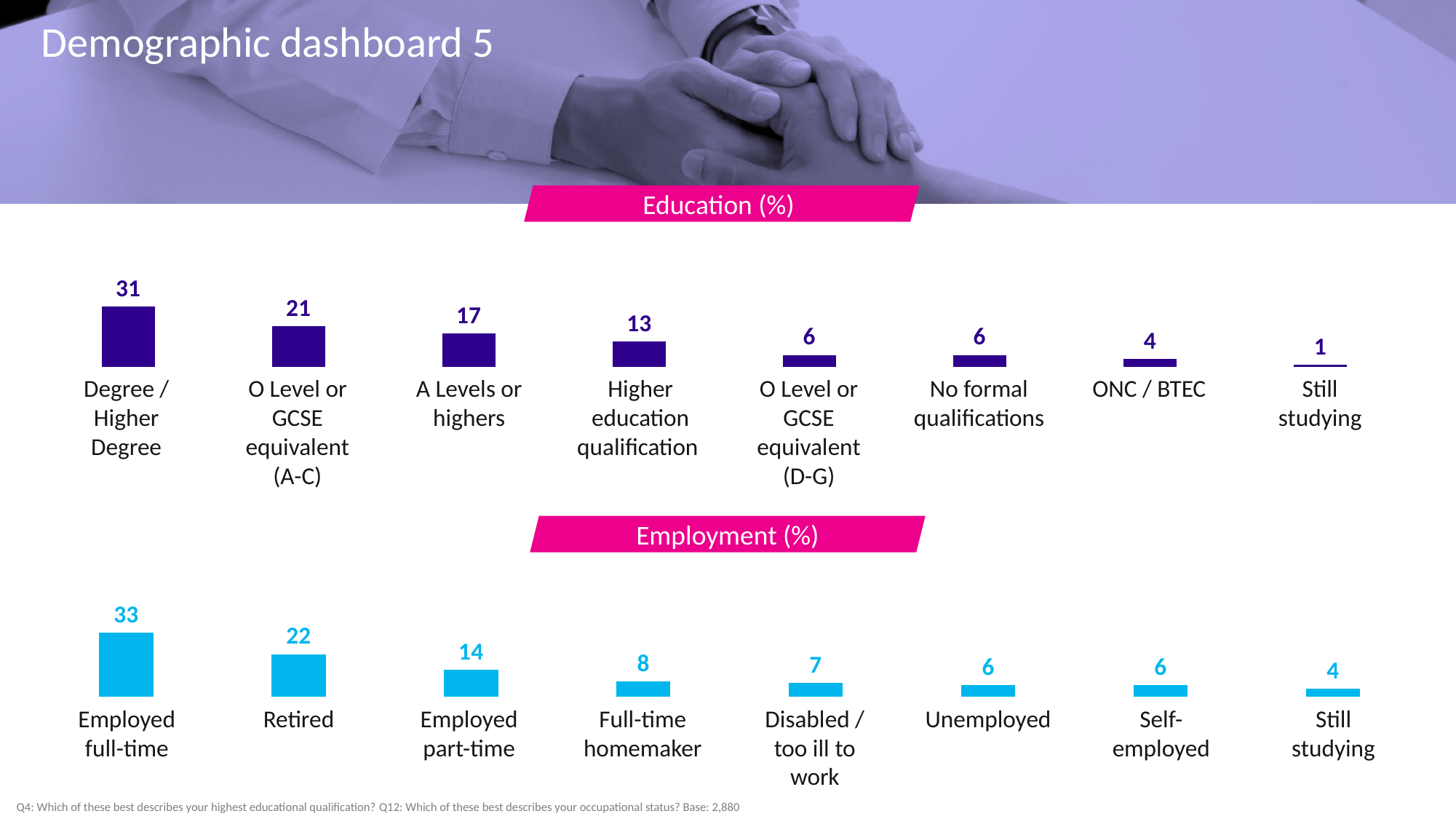
In the Employment (%) chart, what is the difference between Employed full-time and Retired? 11 What kind of chart is the Employment (%) chart? Bar chart In the Employment (%) chart, which is larger, Employed part-time or Full-time homemaker? Employed part-time In the Education (%) chart, what is the value for A Levels or highers? 17 In the Education (%) chart, what is the value for Degree / Higher Degree? 31 In the Education (%) chart, which category has the lowest value? Still studying In the Education (%) chart, what is the difference between Degree / Higher Degree and O Level or GCSE equivalent (A-C)? 10 In the Employment (%) chart, what is the value for Retired? 22 In the Employment (%) chart, what is the value for Disabled / too ill to work? 7 In the Education (%) chart, how many categories are shown? 8 In the Employment (%) chart, which category has the highest value? Employed full-time In the Education (%) chart, do the values rise or fall from left to right? Fall